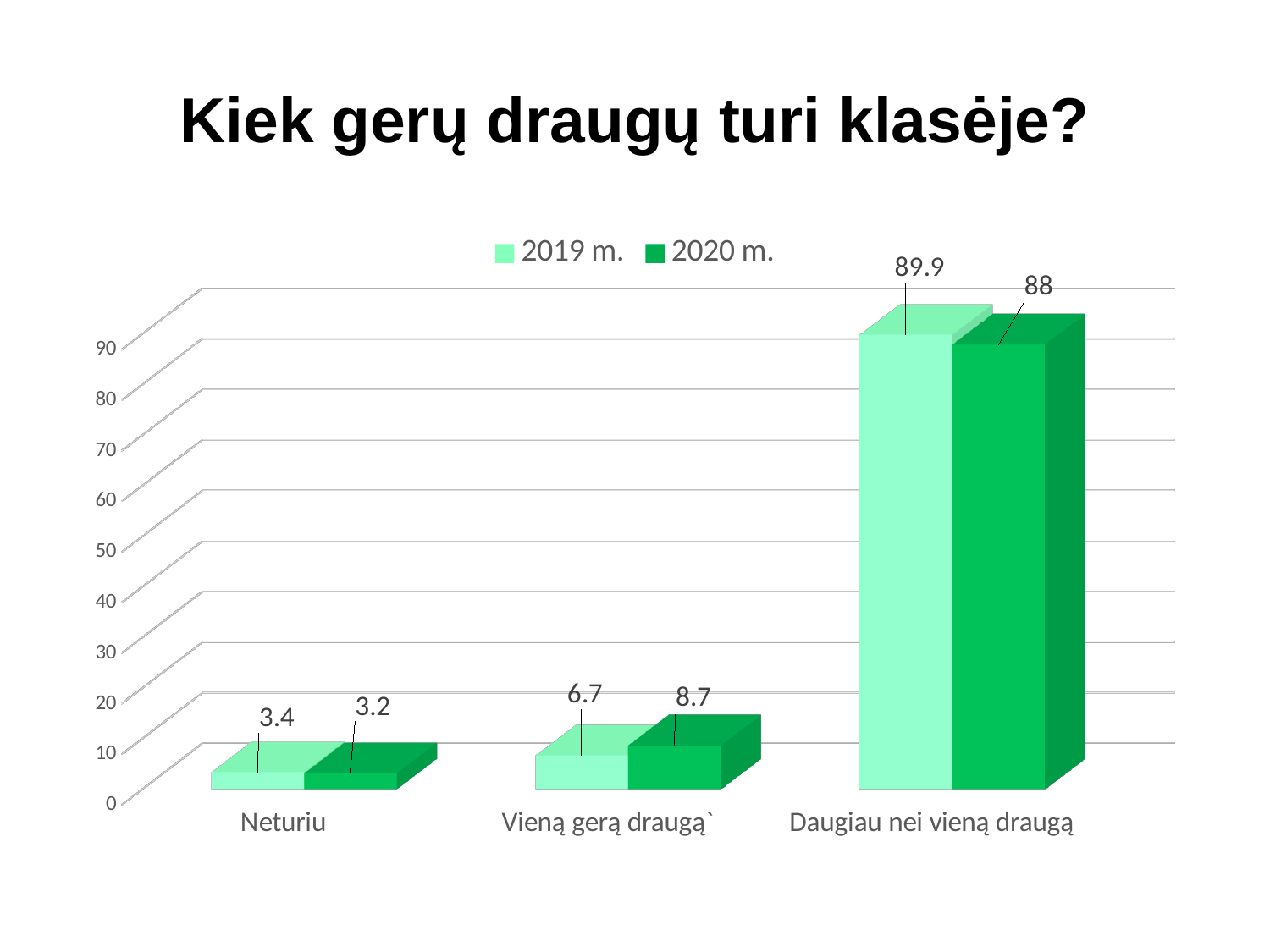
How many series does the legend list? 2 Which category has the lowest value in the 2019 m. series? Neturiu What is the difference between the 2019 m. and 2020 m. values for "Daugiau nei vieną draugą"? 1.9 What is the value for "Vieną gerą draugą" in the 2020 m. series? 8.7 How many categories are shown on the x axis? 3 What is the value for "Daugiau nei vieną draugą" in the 2019 m. series? 89.9 Which category has the highest value in the 2020 m. series? Daugiau nei vieną draugą What is the value for "Neturiu" in the 2019 m. series? 3.4 What is the title of the slide? Kiek gerų draugų turi klasėje? For "Vieną gerą draugą", which series has the larger value, 2019 m. or 2020 m.? 2020 m. What kind of chart is shown on the slide? Bar chart What is the value for "Neturiu" in the 2020 m. series? 3.2